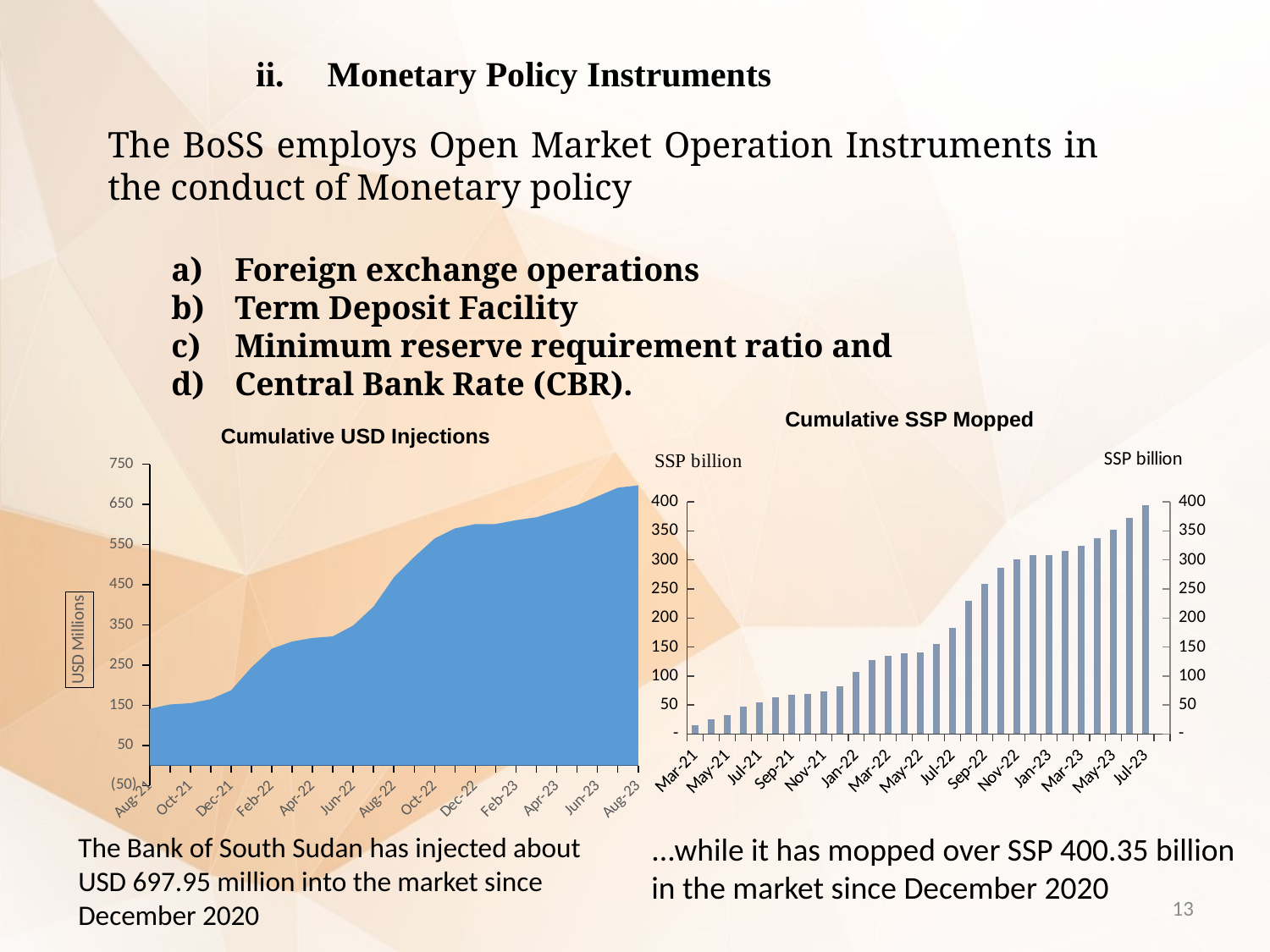
What kind of chart is the 'Cumulative USD Injections' chart? area chart In the 'Cumulative SSP Mopped' chart, do the values rise or fall from Mar-21 to Jul-23? rise What kind of chart is the 'Cumulative SSP Mopped' chart? bar chart In the 'Cumulative USD Injections' chart, is the value for Aug-21 greater or less than 250? less In the 'Cumulative SSP Mopped' chart, is the value for Sep-22 greater or less than 250? greater In the 'Cumulative SSP Mopped' chart, which month has the lowest value? Mar-21 In the 'Cumulative USD Injections' chart, is the value for Aug-23 greater or less than 650? greater In the 'Cumulative SSP Mopped' chart, which month has the highest value? Jul-23 In the 'Cumulative USD Injections' chart, do the values rise or fall from Aug-21 to Aug-23? rise What is the y-axis label of the 'Cumulative USD Injections' chart? USD Millions